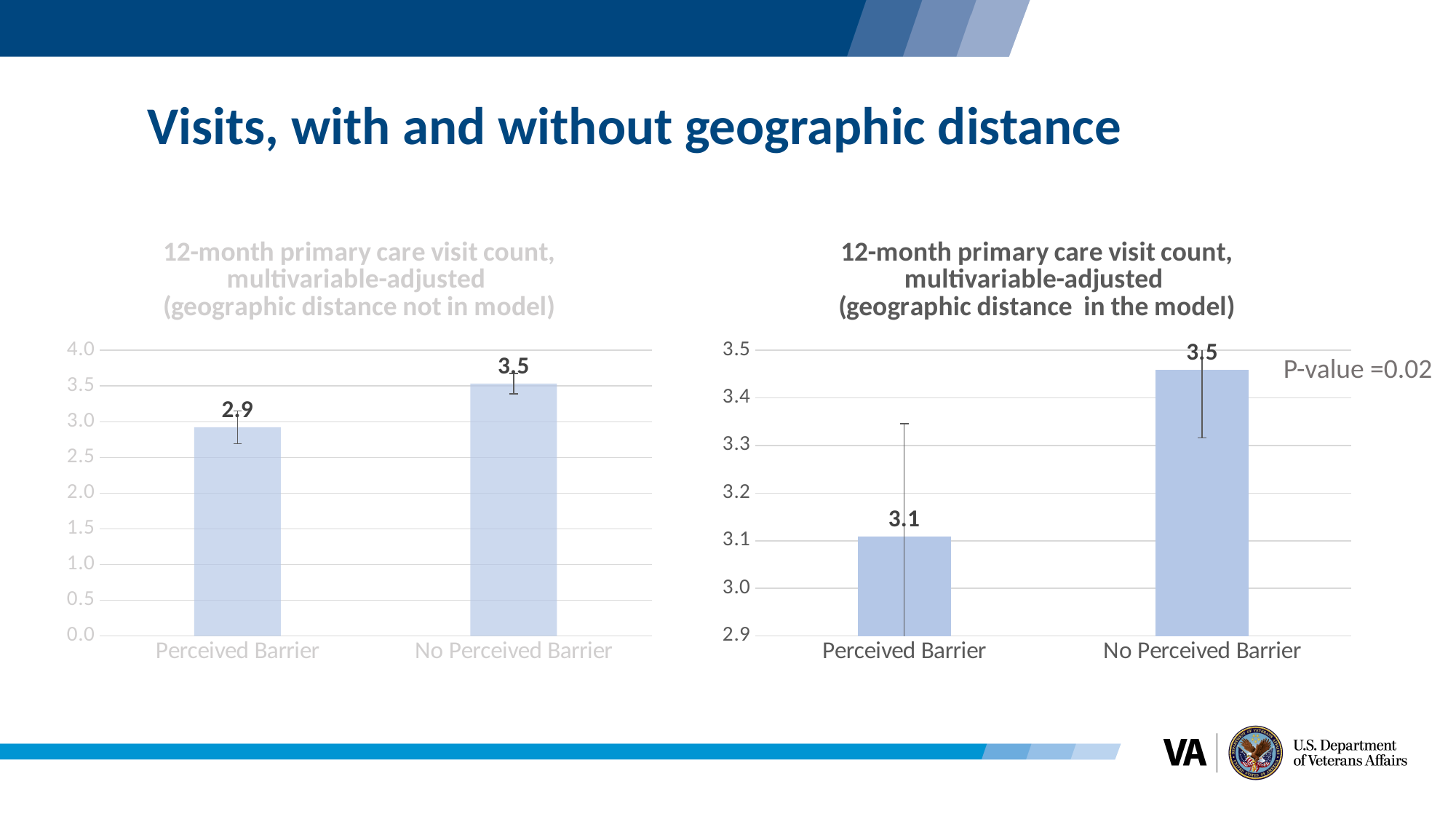
In the right chart (geographic distance in the model), is the value for Perceived Barrier greater or less than 3.0? greater How many categories are shown on the x axis of the left chart (geographic distance not in model)? 2 What P-value is shown on the right chart (geographic distance in the model)? P-value =0.02 In the left chart (geographic distance not in model), which category has the higher visit count? No Perceived Barrier In the left chart (geographic distance not in model), what is the 12-month primary care visit count for Perceived Barrier? 2.9 In the right chart (geographic distance in the model), what is the visit count for Perceived Barrier? 3.1 In the right chart (geographic distance in the model), which category has the lower visit count? Perceived Barrier What type of chart is the right chart (geographic distance in the model)? Bar chart In the left chart (geographic distance not in model), what is the 12-month primary care visit count for No Perceived Barrier? 3.5 In the right chart (geographic distance in the model), what is the difference between the No Perceived Barrier and Perceived Barrier visit counts? 0.4 In the left chart (geographic distance not in model), what is the difference between the No Perceived Barrier and Perceived Barrier visit counts? 0.6 In the right chart (geographic distance in the model), what is the visit count for No Perceived Barrier? 3.5